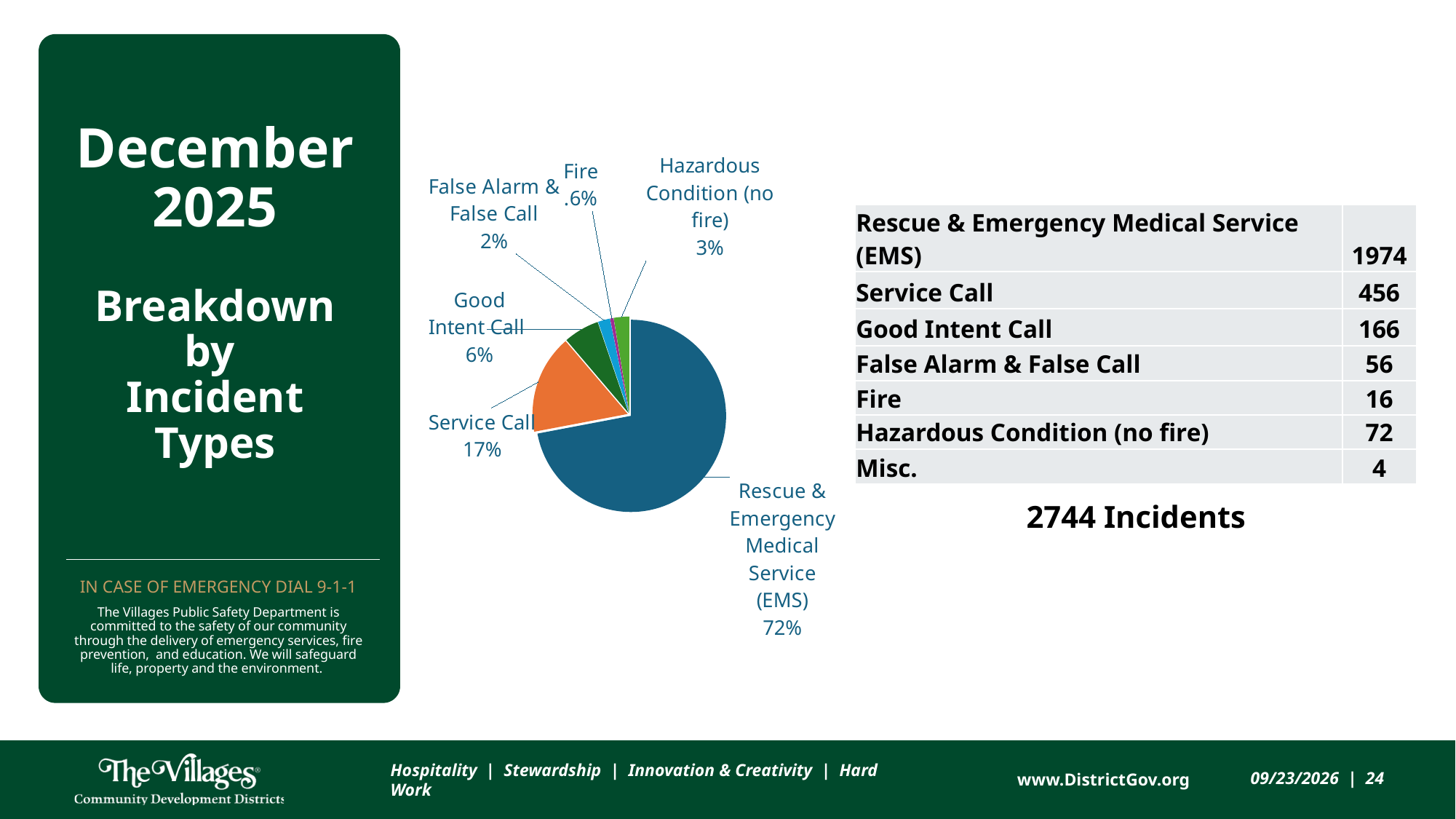
Which slice is larger in the pie chart, Service Call or Good Intent Call? Service Call What percentage is shown for Good Intent Call in the pie chart? 6% What colour is the Rescue & Emergency Medical Service (EMS) slice in the pie chart? blue What percentage is shown for False Alarm & False Call in the pie chart? 2% Which labeled incident type has the smallest slice of the pie chart? Fire What percentage is shown for Service Call in the pie chart? 17% What percentage is shown for Hazardous Condition (no fire) in the pie chart? 3% What share of the pie does Rescue & Emergency Medical Service (EMS) represent? 72% What type of chart is shown on the slide? pie chart What is the difference in percentage points between the Service Call slice and the Good Intent Call slice? 11 Which incident type has the largest slice of the pie chart? Rescue & Emergency Medical Service (EMS) What percentage is shown for Fire in the pie chart? .6%